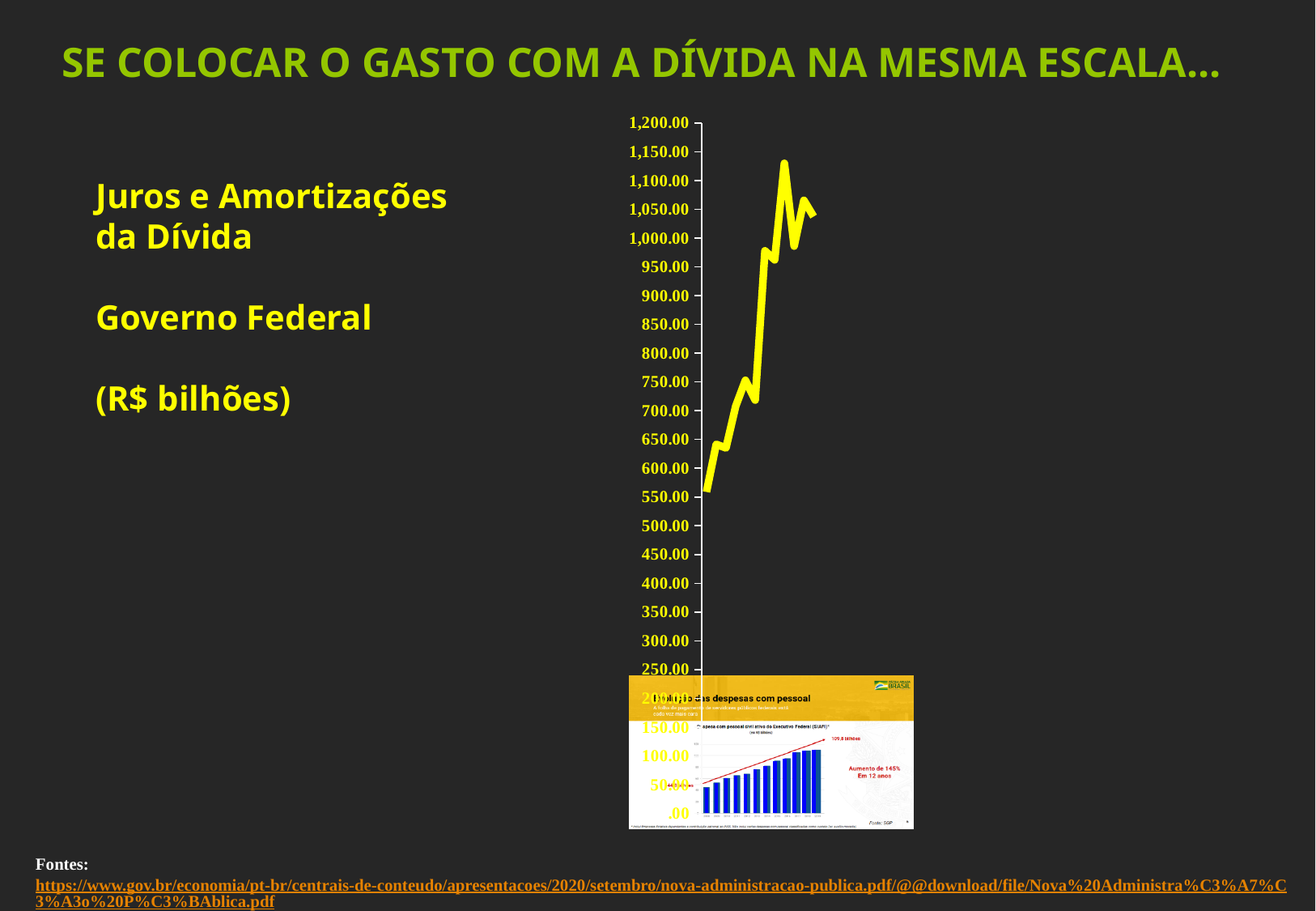
In what unit are the values of the large line chart expressed, according to the text on the slide? R$ bilhões In the large line chart, do the values generally rise or fall from left to right? rise In the large line chart, is the first (leftmost) point of the line greater or less than 600.00? less In the small inset bar chart at the bottom of the slide, do the bars rise or fall from left to right? rise In the large line chart, is the last (rightmost) point of the line greater or less than 1,000.00? greater In the large line chart, is the lowest point of the line greater or less than 500.00? greater What kind of chart is shown in the small inset image at the bottom of the slide? bar chart What is the highest tick value shown on the y-axis of the large line chart? 1,200.00 What kind of chart is the large chart on the right of the slide? line chart